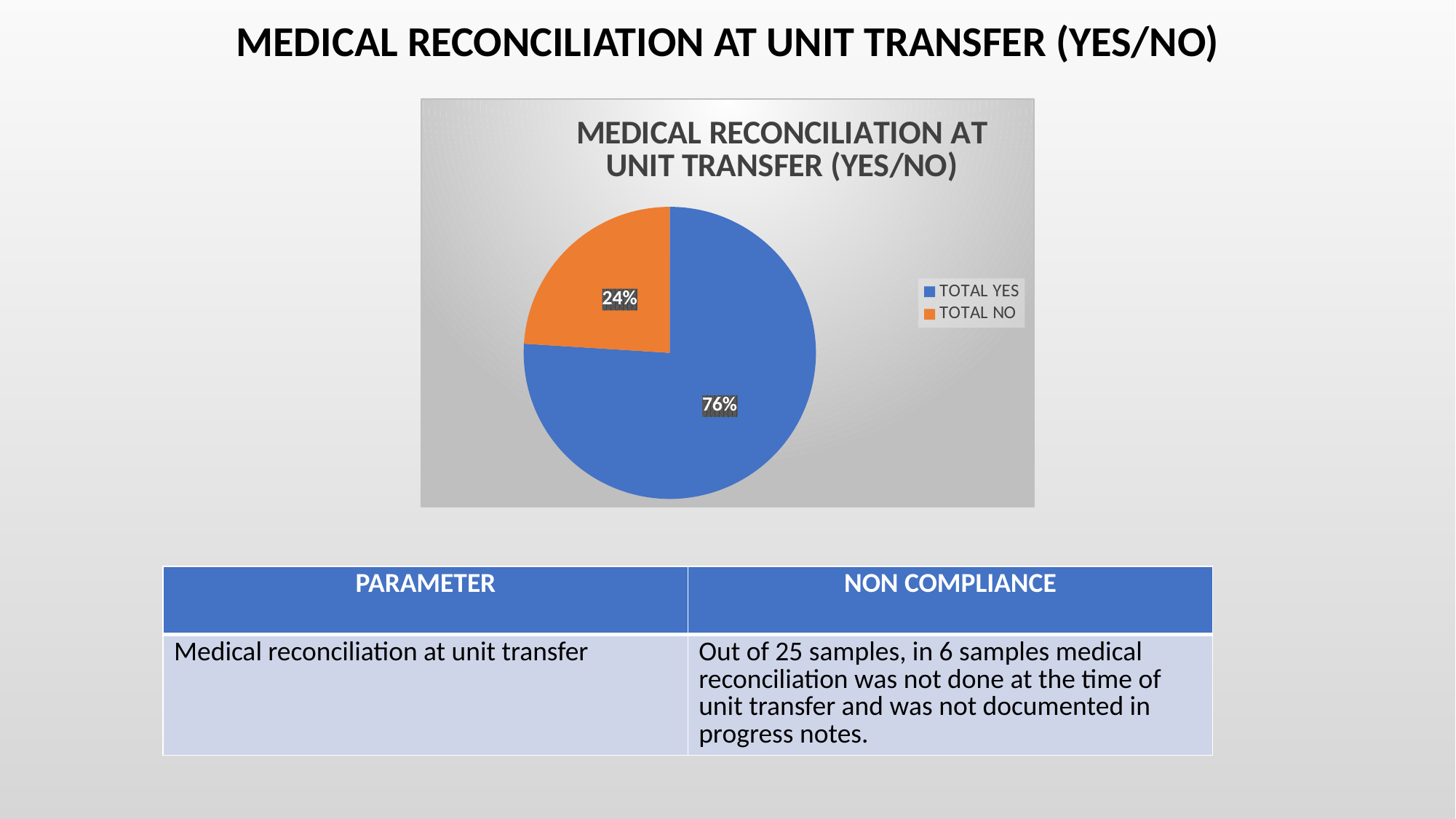
What is the title of the chart? MEDICAL RECONCILIATION AT UNIT TRANSFER (YES/NO) How many slices does the pie chart have? 2 What type of chart is shown on the slide? pie chart Which is larger, TOTAL YES or TOTAL NO? TOTAL YES What is the difference in percentage points between TOTAL YES and TOTAL NO? 52 What percentage of the pie is TOTAL NO? 24% What colour is the TOTAL NO slice? orange What percentage of the pie is TOTAL YES? 76% Which slice is the largest in the pie chart? TOTAL YES How many entries does the legend list? 2 Which slice is the smallest in the pie chart? TOTAL NO What share of the pie does the TOTAL YES slice represent? 76%